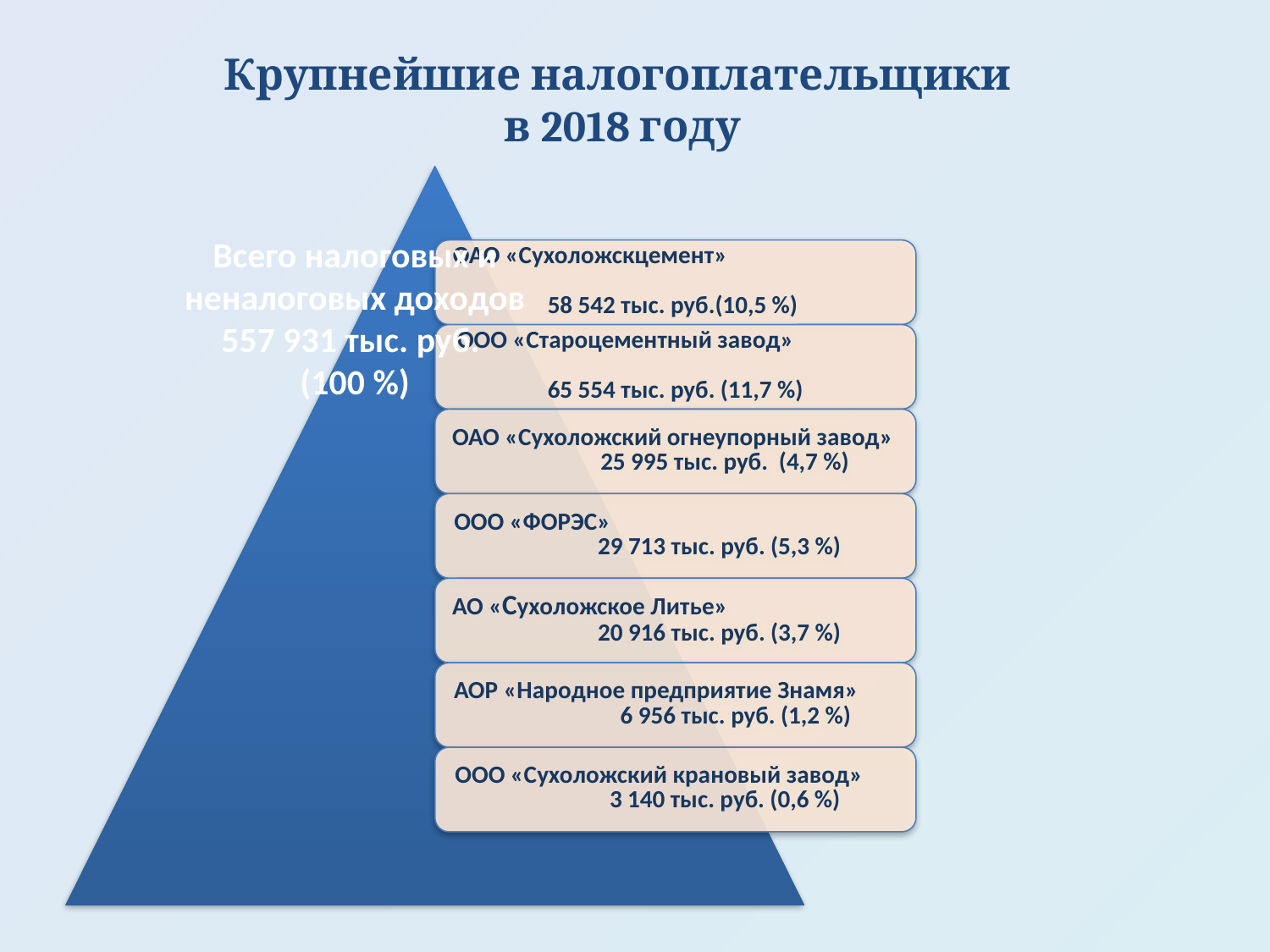
What percentage is shown for АОР «Народное предприятие Знамя»? 1,2 % What is the total of all tax and non-tax revenues shown on the slide? 557 931 тыс. руб. Which taxpayer has the smallest amount on the slide? ООО «Сухоложский крановый завод» Which is larger: the amount for АО «Сухоложское Литье» or for ОАО «Сухоложский огнеупорный завод»? ОАО «Сухоложский огнеупорный завод» What share of total revenues does ООО «Староцементный завод» account for? 11,7 % What is the difference in тыс. руб. between ООО «Староцементный завод» and ОАО «Сухоложскцемент»? 7 012 тыс. руб. How many taxpayers are listed on the slide? 7 What is the difference in тыс. руб. between ООО «ФОРЭС» and ОАО «Сухоложский огнеупорный завод»? 3 718 тыс. руб. How much tax did ОАО «Сухоложскцемент» pay in 2018 according to the slide? 58 542 тыс. руб. Which taxpayer has the largest amount on the slide? ООО «Староцементный завод» What is the amount shown for ООО «ФОРЭС»? 29 713 тыс. руб. What is the title of the slide? Крупнейшие налогоплательщики в 2018 году